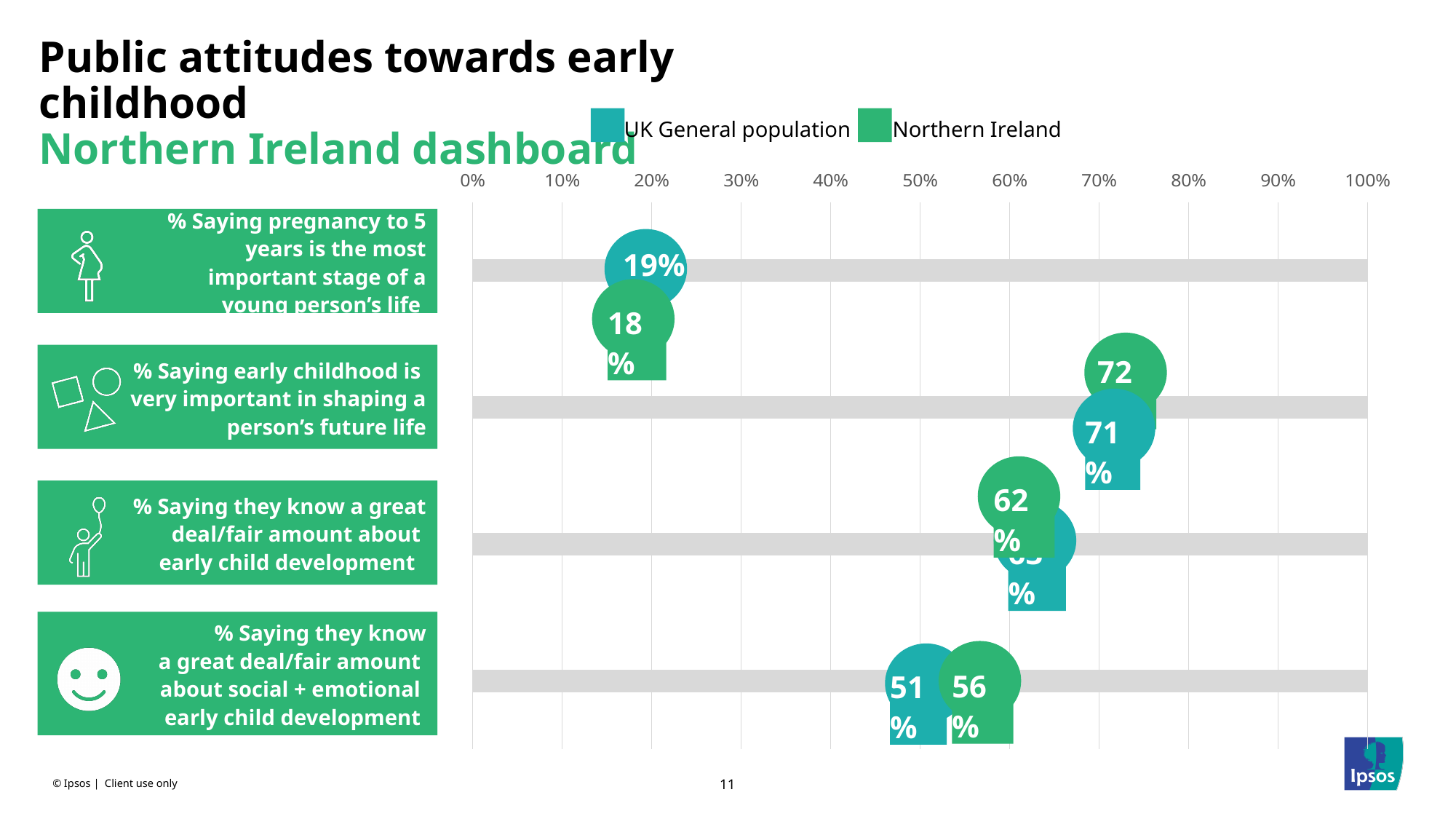
What percentage of Northern Ireland respondents say pregnancy to 5 years is the most important stage of a young person's life? 18% What percentage of the UK General population say pregnancy to 5 years is the most important stage of a young person's life? 19% Which statement has the highest Northern Ireland value? % Saying early childhood is very important in shaping a person's future life What is the difference between the Northern Ireland and UK General population values for knowing a great deal/fair amount about social + emotional early child development? 5 percentage points What percentage of the UK General population say early childhood is very important in shaping a person's future life? 71% How many statements (categories) are shown on the chart? 4 What percentage of Northern Ireland respondents say they know a great deal/fair amount about social + emotional early child development? 56% How many series does the legend list? 2 What percentage of Northern Ireland respondents say they know a great deal/fair amount about early child development? 62% For saying pregnancy to 5 years is the most important stage, which is higher: the UK General population or Northern Ireland? UK General population Is the UK General population value for knowing a great deal/fair amount about early child development greater or less than 60%? greater What percentage of Northern Ireland respondents say early childhood is very important in shaping a person's future life? 72%